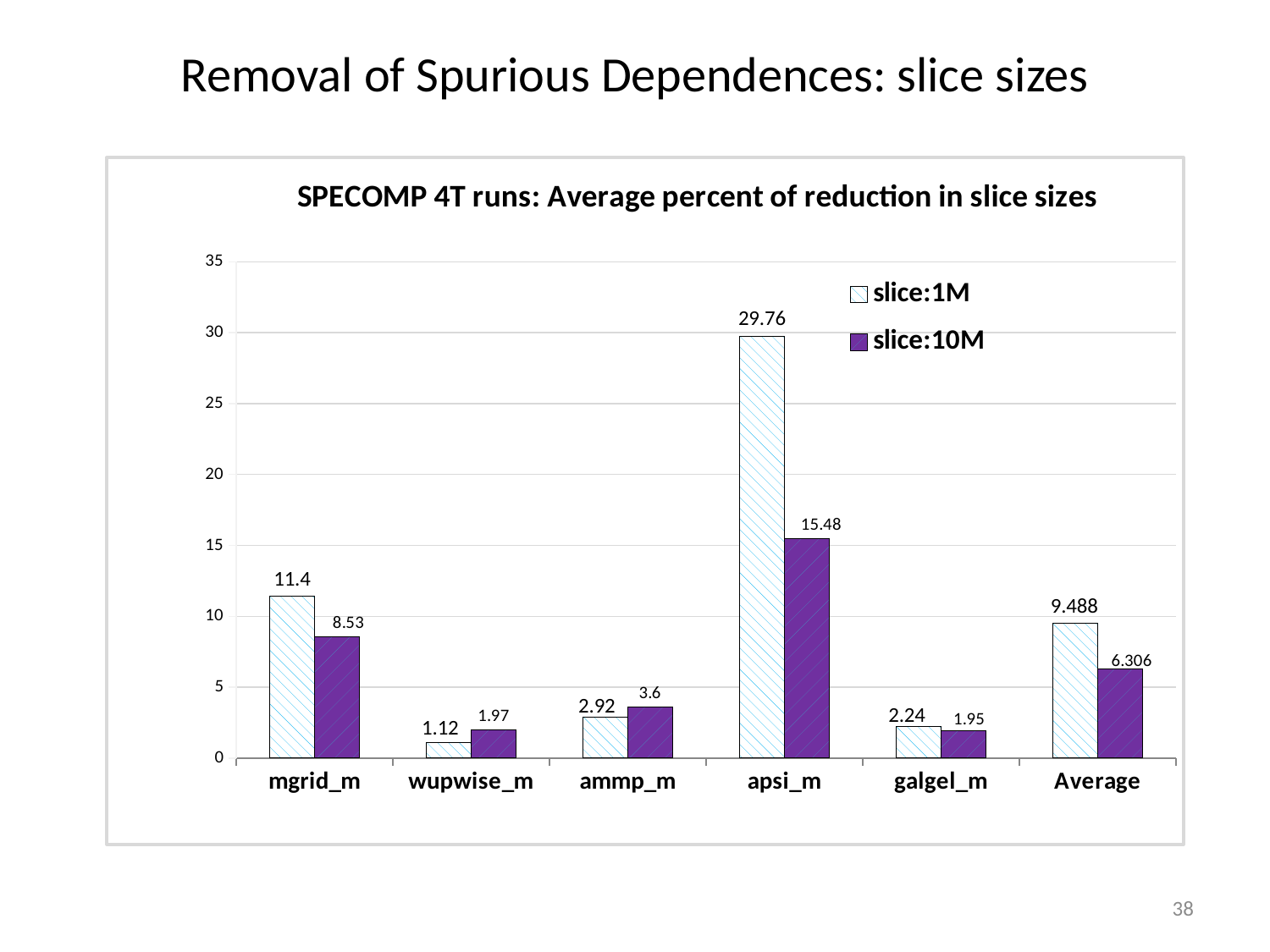
What is the slice:10M value for mgrid_m? 8.53 Which category has the lowest slice:10M value? galgel_m What kind of chart is shown on the slide? bar chart For ammp_m, which is larger: the slice:1M value or the slice:10M value? slice:10M What is the title of the chart? SPECOMP 4T runs: Average percent of reduction in slice sizes What is the slice:1M value for wupwise_m? 1.12 How many categories are shown on the x axis? 6 What is the slice:1M value for apsi_m? 29.76 Which category has the highest slice:1M value? apsi_m What is the difference between the slice:1M and slice:10M values for apsi_m? 14.28 What is the slice:10M value for Average? 6.306 How many series does the legend list? 2